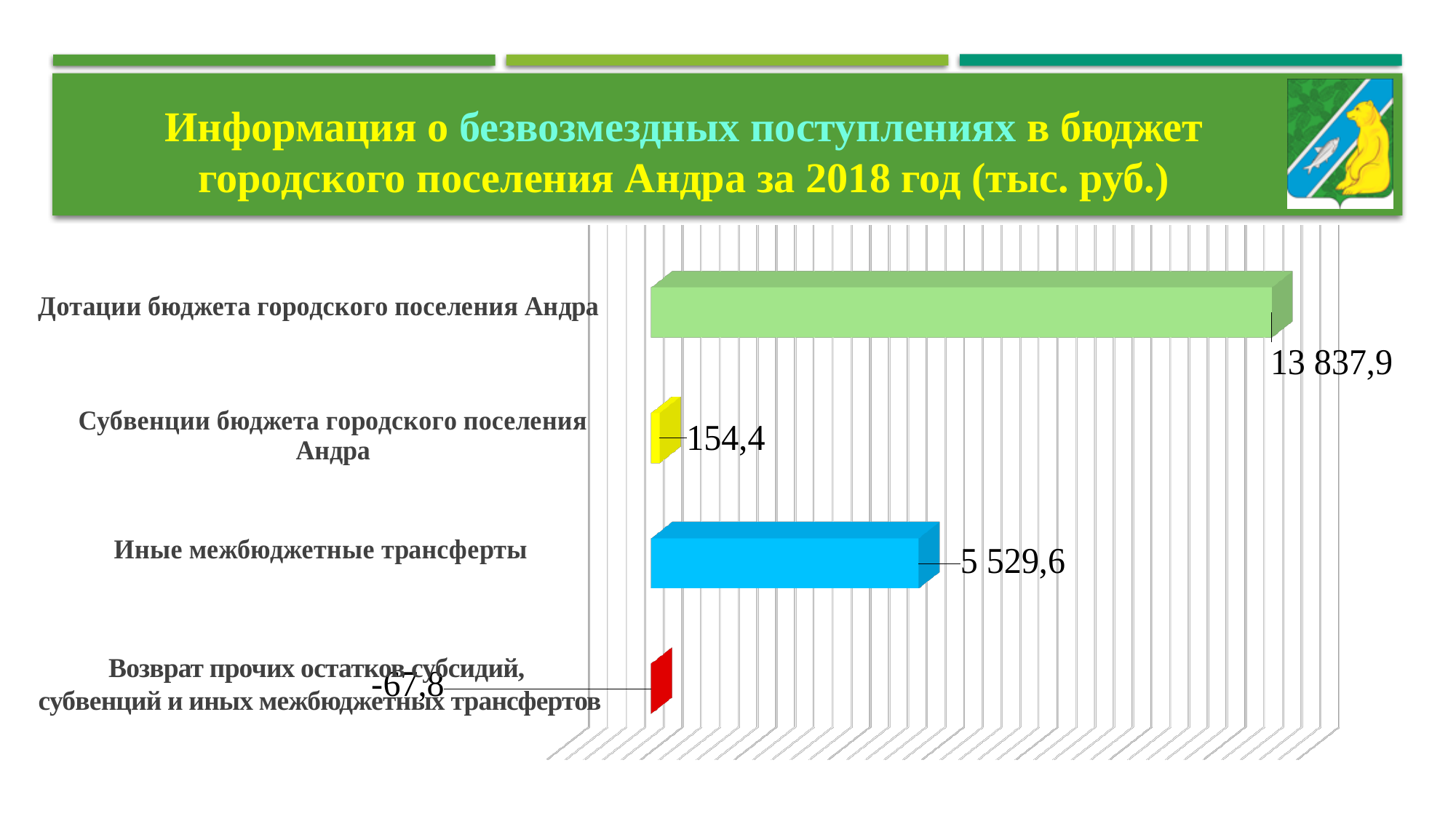
What is the value for «Иные межбюджетные трансферты»? 5 529,6 Which category has the highest value? Дотации бюджета городского поселения Андра Which is larger: the value for «Иные межбюджетные трансферты» or for «Субвенции бюджета городского поселения Андра»? Иные межбюджетные трансферты How many categories are shown in the chart? 4 What is the difference between the values for «Иные межбюджетные трансферты» and «Субвенции бюджета городского поселения Андра»? 5 375,2 What is the value for «Возврат прочих остатков субсидий, субвенций и иных межбюджетных трансфертов»? -67,8 What kind of chart is shown on the slide? Bar chart What is the value for «Дотации бюджета городского поселения Андра»? 13 837,9 What is the difference between the values for «Дотации бюджета городского поселения Андра» and «Иные межбюджетные трансферты»? 8 308,3 Which category has the lowest value? Возврат прочих остатков субсидий, субвенций и иных межбюджетных трансфертов What colour is the bar for «Иные межбюджетные трансферты»? Blue What is the value for «Субвенции бюджета городского поселения Андра»? 154,4